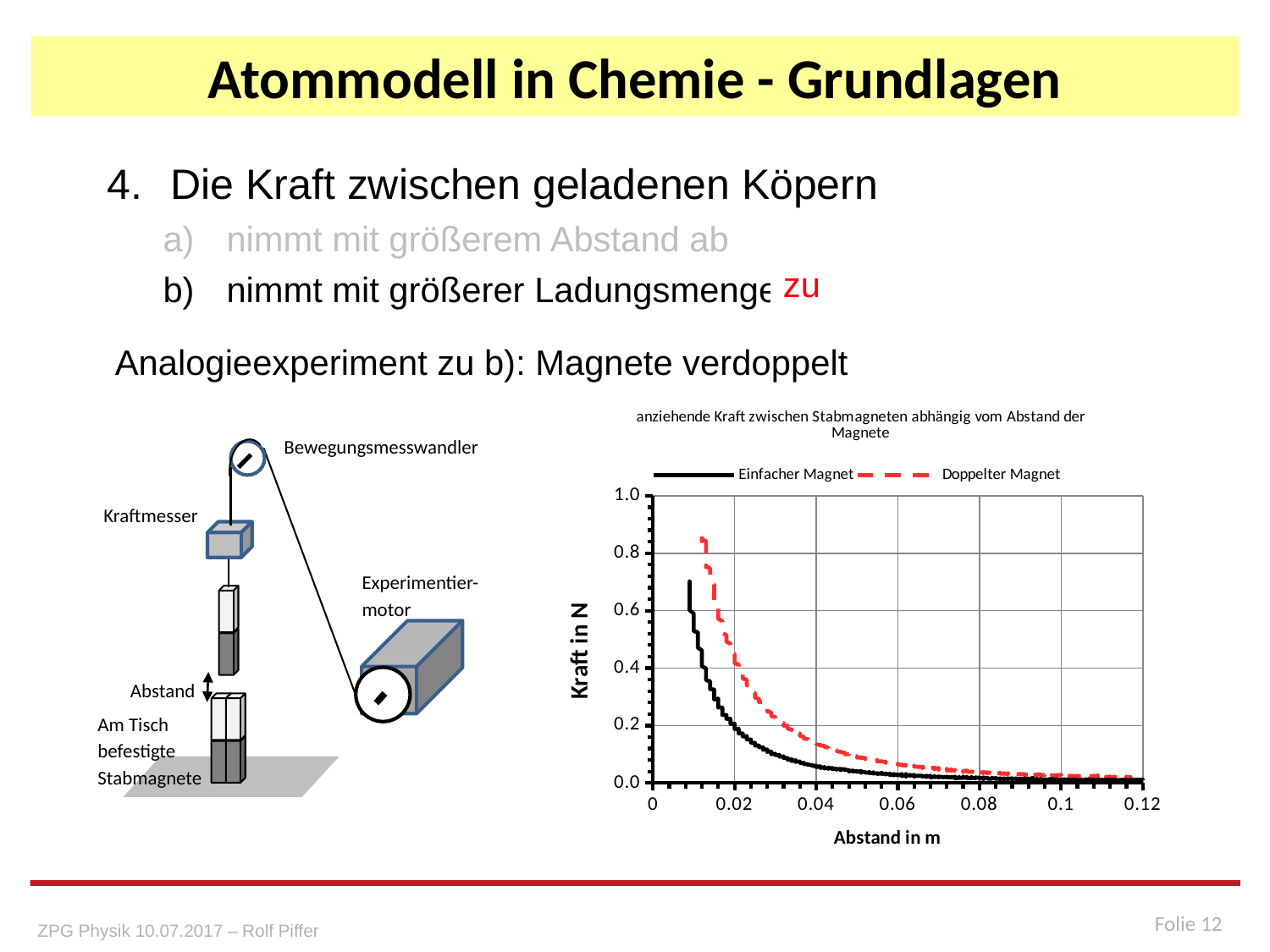
Is the highest force reached by the Einfacher Magnet series greater or less than 0.6 N? greater What kind of chart is shown on the slide? line chart How many series does the legend of the chart list? 2 At a distance of 0.04 m, which series shows the larger force, Einfacher Magnet or Doppelter Magnet? Doppelter Magnet What is the title of the chart? anziehende Kraft zwischen Stabmagneten abhängig vom Abstand der Magnete At a distance of 0.02 m, is the force for Doppelter Magnet greater or less than 0.2 N? greater Which series is drawn as a red dashed line? Doppelter Magnet Is the highest force reached by the Doppelter Magnet series greater or less than 0.6 N? greater Does the force (Kraft in N) rise or fall as the distance (Abstand in m) increases? fall Which series reaches the higher maximum force, Einfacher Magnet or Doppelter Magnet? Doppelter Magnet